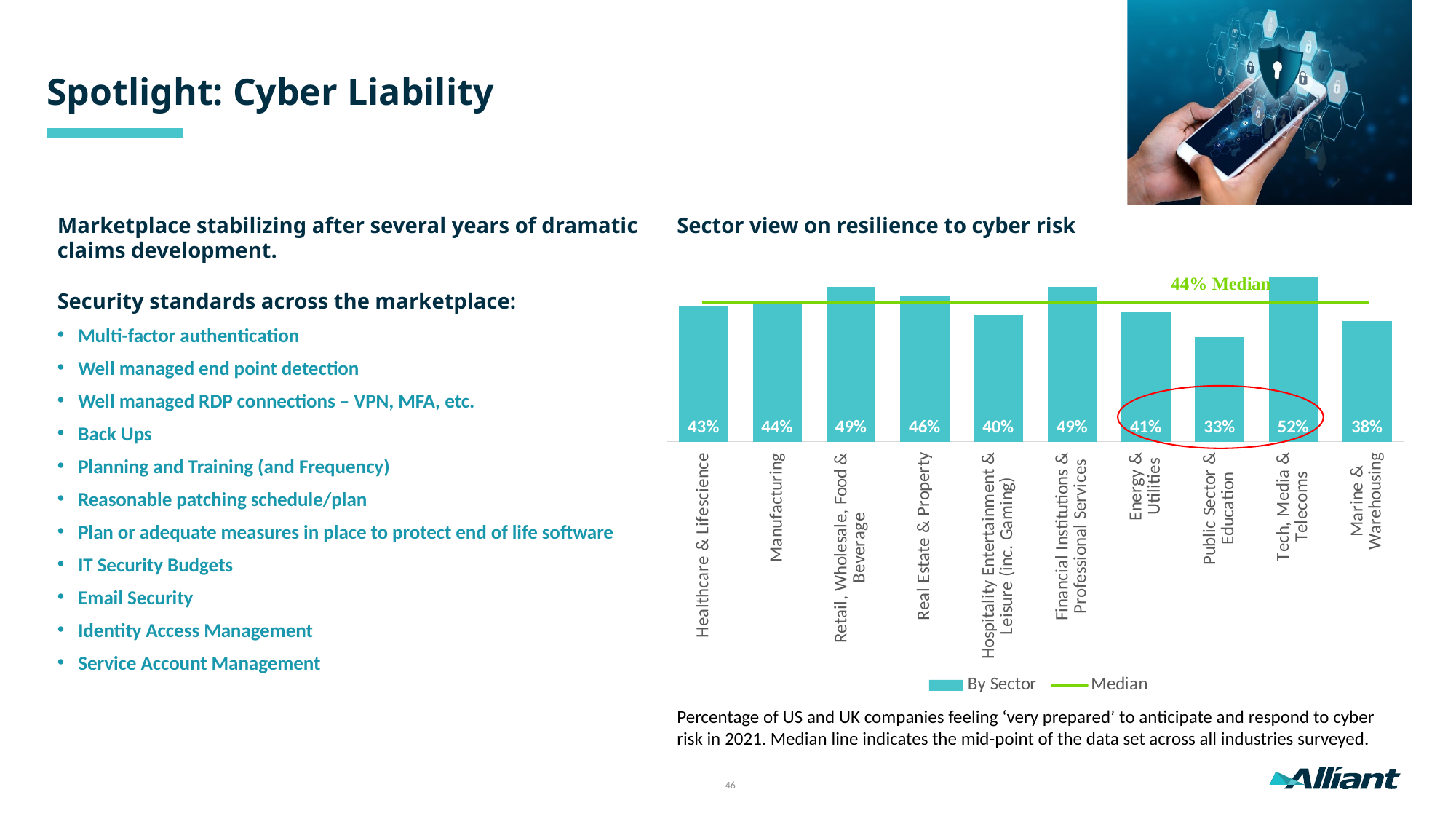
What is the value for Public Sector & Education? 33% How many sectors are shown in the chart? 10 What is the title of the chart? Sector view on resilience to cyber risk What is the value for Hospitality Entertainment & Leisure (inc. Gaming)? 40% What is the value for Manufacturing? 44% Which is larger, the value for Real Estate & Property or the value for Marine & Warehousing? Real Estate & Property What kind of chart is shown? Bar chart with a median line (combination bar and line chart) Which sector has the lowest value? Public Sector & Education Which sector has the highest value? Tech, Media & Telecoms What median value is labelled on the chart? 44% Median How many entries does the legend list? 2 What is the difference between the values for Tech, Media & Telecoms and Public Sector & Education? 19%